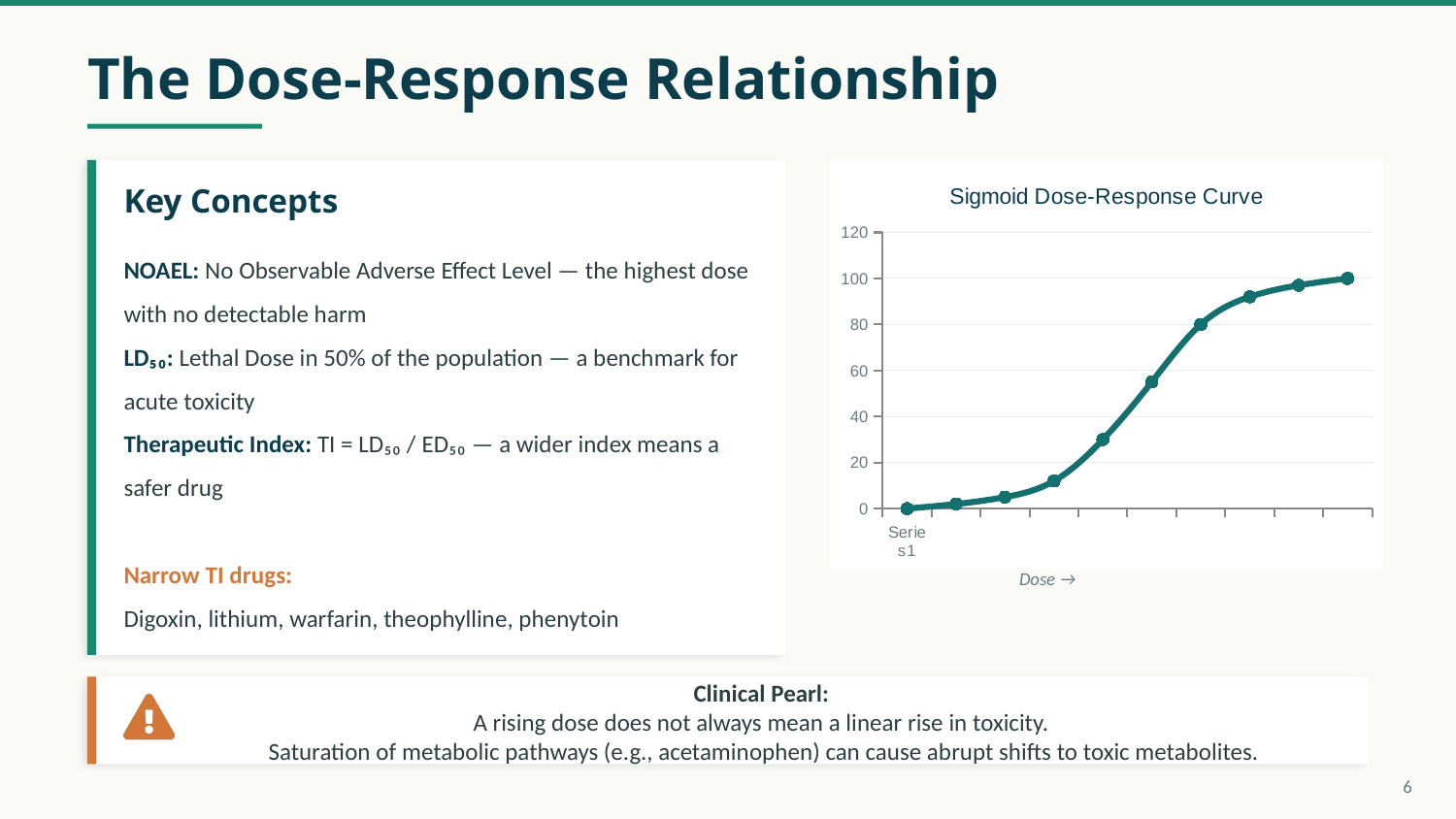
Is the value of the sixth point from the left on the curve greater or less than 40? greater What is the highest value shown on the chart's vertical axis? 120 Which point on the curve has the highest value, the first or the last? the last Do the values on the Sigmoid Dose-Response Curve rise or fall from left to right? rise What is the title of the chart on the slide? Sigmoid Dose-Response Curve Is the value of the fourth point from the left on the curve greater or less than 20? less Which point on the curve has the lowest value, the first or the last? the first How many data points are plotted on the Sigmoid Dose-Response Curve? 10 Is the value of the seventh point from the left on the curve greater or less than 60? greater What kind of chart is shown on the slide? line chart